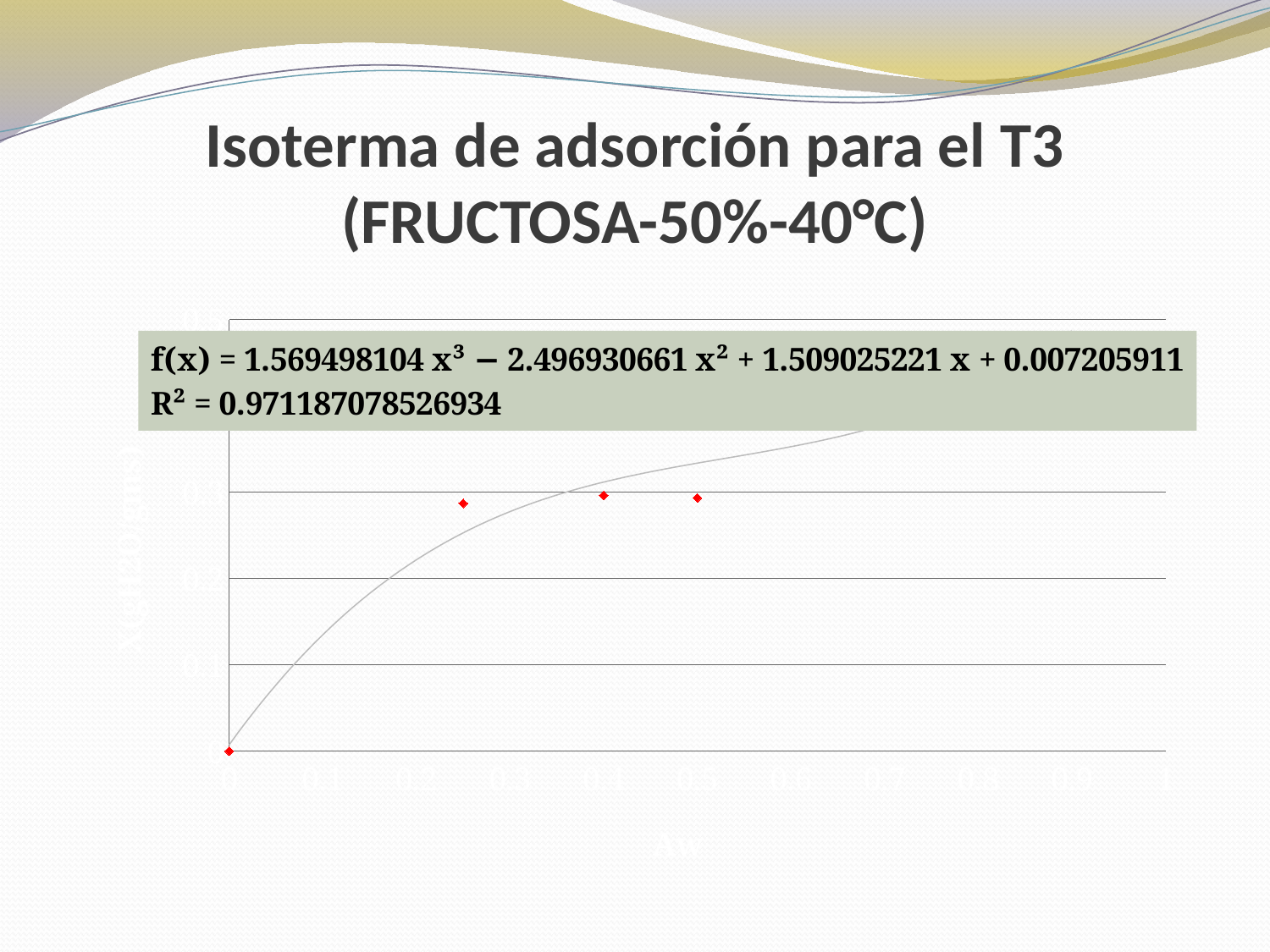
Is the value of the data point at x = 0.4 greater or less than 0.1? greater Which data point has the lowest value on the chart? the point at x = 0 What kind of chart is shown on the slide? scatter chart Is the value of the data point at x = 0.5 greater or less than 0.2? greater Do the plotted values rise or fall as the x value increases from 0 to 0.5? rise What is the R² value shown for the trendline? 0.971187078526934 Is the value of the data point at x = 0 greater or less than 0.1? less What is the constant term in the trendline equation f(x)? 0.007205911